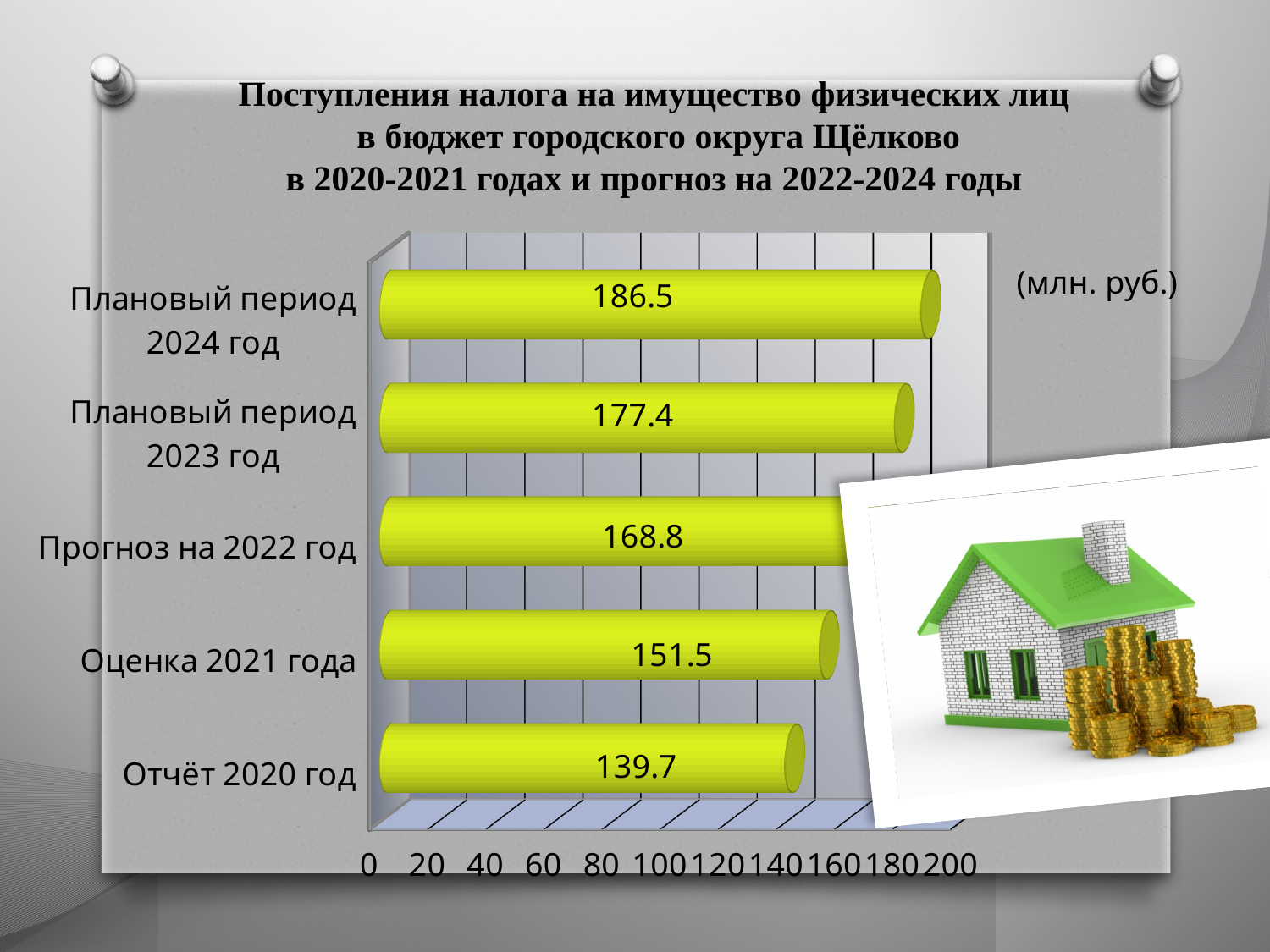
What is the value for Оценка 2021 года? 151.5 What is the difference between the values for Плановый период 2024 год and Отчёт 2020 год? 46.8 Which category has the lowest value? Отчёт 2020 год What is the value for Плановый период 2024 год? 186.5 What kind of chart is shown on the slide? bar chart Which is larger: the value for Оценка 2021 года or the value for Прогноз на 2022 год? Прогноз на 2022 год How many categories are shown in the chart? 5 What is the value for Отчёт 2020 год? 139.7 What is the value for Плановый период 2023 год? 177.4 What is the value for Прогноз на 2022 год? 168.8 What unit is indicated next to the chart? млн. руб. Which category has the highest value? Плановый период 2024 год